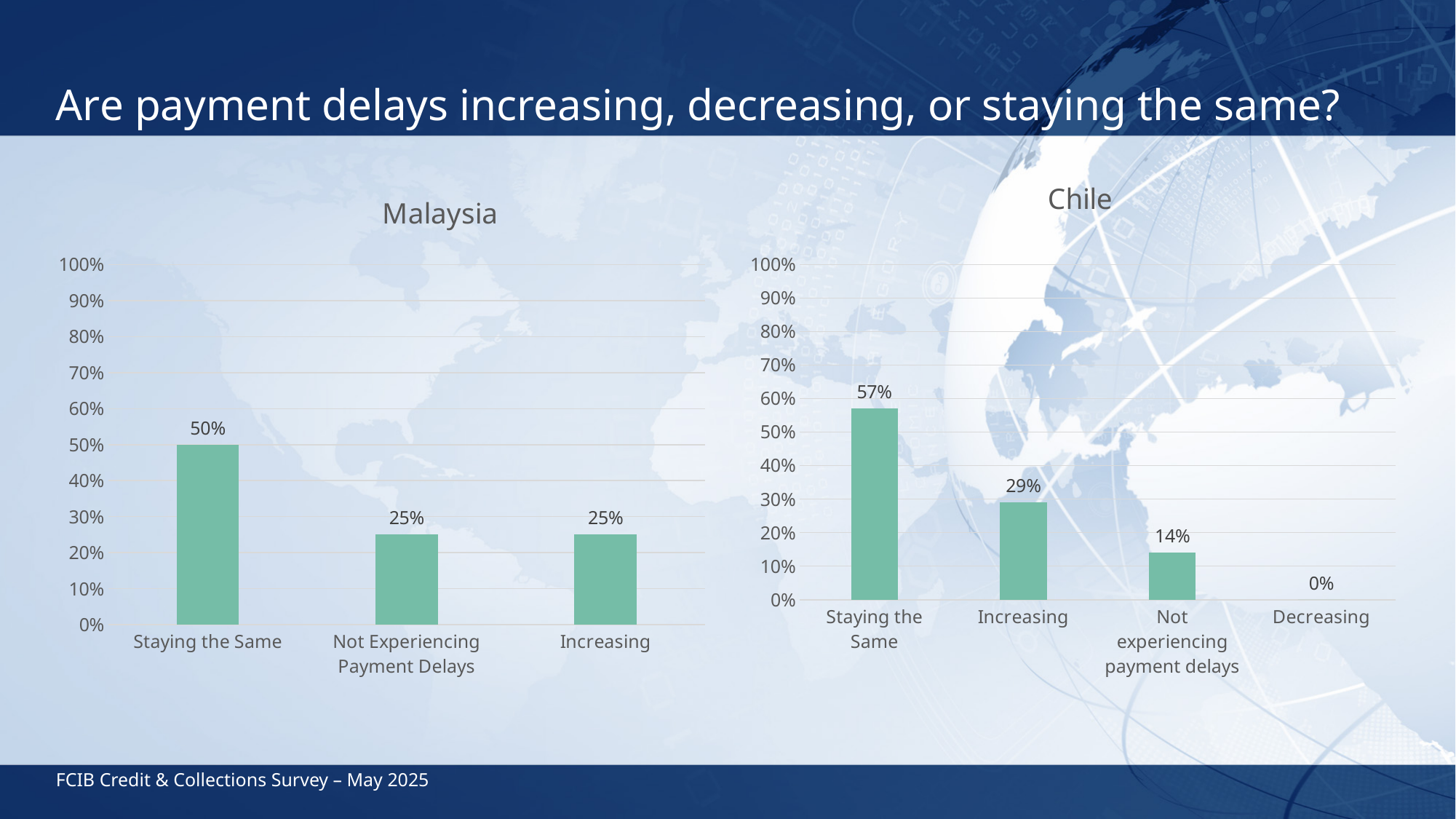
In the Malaysia chart, which category has the highest value? Staying the Same Which is larger: Staying the Same in the Chile chart or Staying the Same in the Malaysia chart? Chile How many categories does the Chile chart show? 4 In the Chile chart, what is the value for Increasing? 29% In the Malaysia chart, what is the value for Not Experiencing Payment Delays? 25% In the Chile chart, which category has the highest value? Staying the Same In the Chile chart, which category has the lowest value? Decreasing In the Chile chart, what is the value for Not experiencing payment delays? 14% In the Malaysia chart, what is the difference between Staying the Same and Increasing? 25% What kind of chart is the Malaysia chart? Bar chart In the Malaysia chart, what is the value for Staying the Same? 50% In the Chile chart, what is the difference between Staying the Same and Increasing? 28%